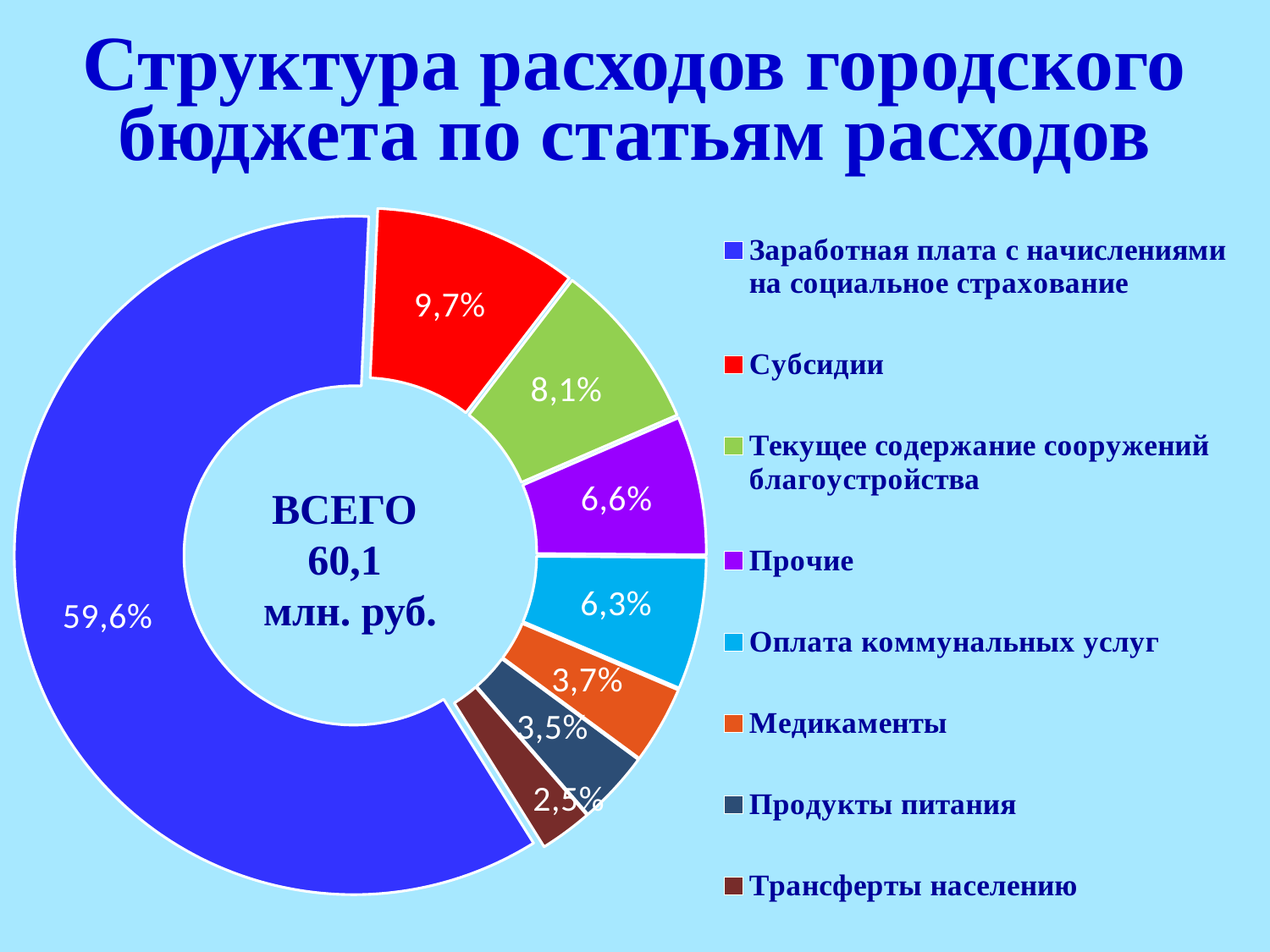
Which expenditure item has the smallest share of the budget? Трансферты населению What share of expenditure goes to Трансферты населению? 2,5% What share of the city budget expenditure goes to Субсидии? 9,7% Which has a larger share: Медикаменты or Оплата коммунальных услуг? Оплата коммунальных услуг What kind of chart is shown on the slide? Doughnut chart What share of expenditure is labelled for Оплата коммунальных услуг? 6,3% What colour is the segment for Прочие? Purple Which expenditure item has the largest share of the budget? Заработная плата с начислениями на социальное страхование What is the difference in percentage points between the shares for Субсидии and Прочие? 3,1 What share of expenditure goes to Текущее содержание сооружений благоустройства? 8,1% What total amount is written in the centre of the chart? 60,1 млн. руб. How many expenditure items are shown in the chart? 8